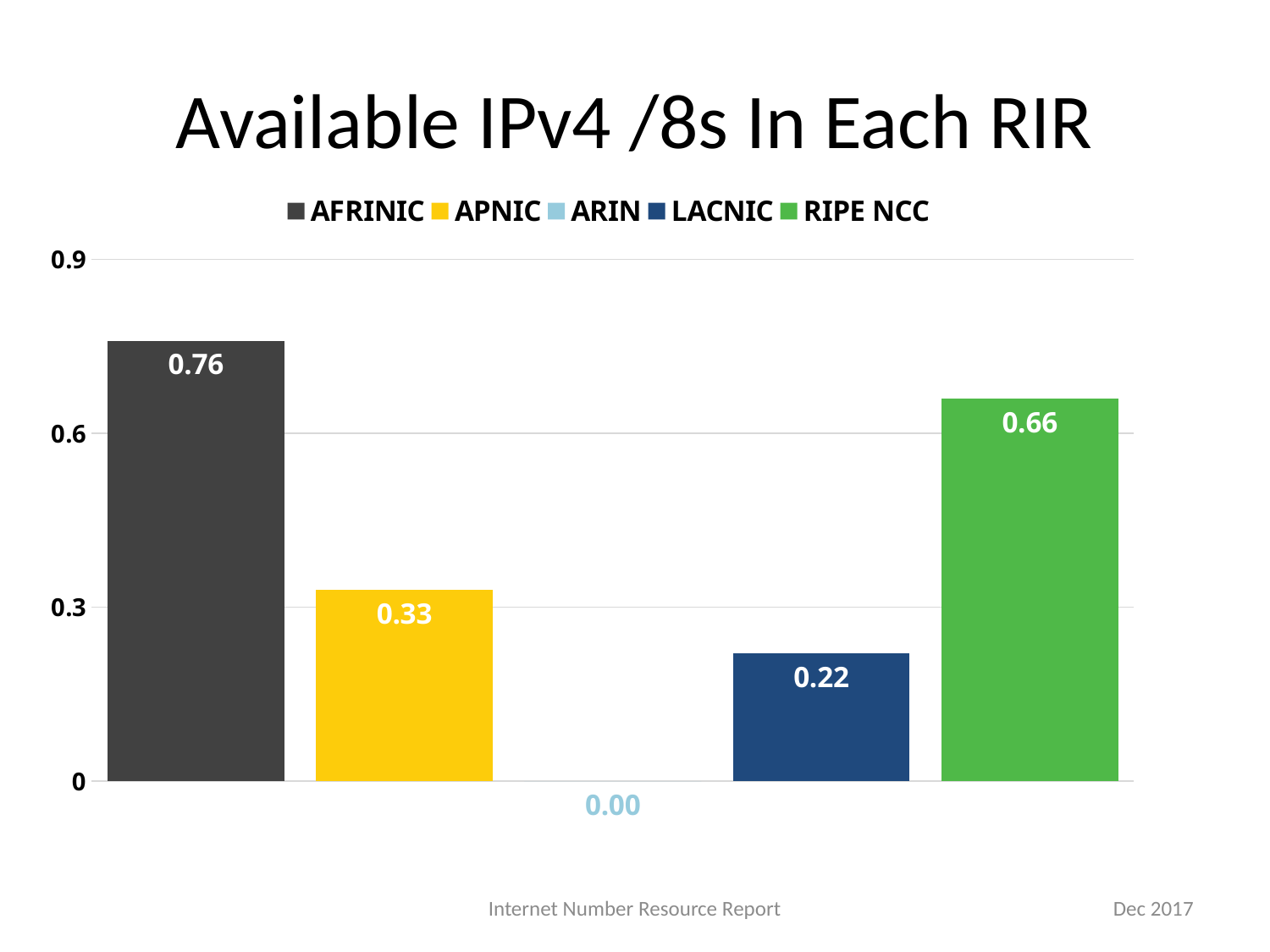
What is the value for RIPE NCC? 0.66 What is the value for ARIN? 0.00 What is the title of the chart? Available IPv4 /8s In Each RIR How many RIRs are shown in the chart? 5 Which is larger, the value for APNIC or the value for LACNIC? APNIC What is the value for APNIC? 0.33 Which RIR has the highest value? AFRINIC What kind of chart is shown on the slide? Bar chart What is the difference between the values for AFRINIC and RIPE NCC? 0.10 Which RIR has the lowest value? ARIN What is the value for AFRINIC? 0.76 What is the value for LACNIC? 0.22